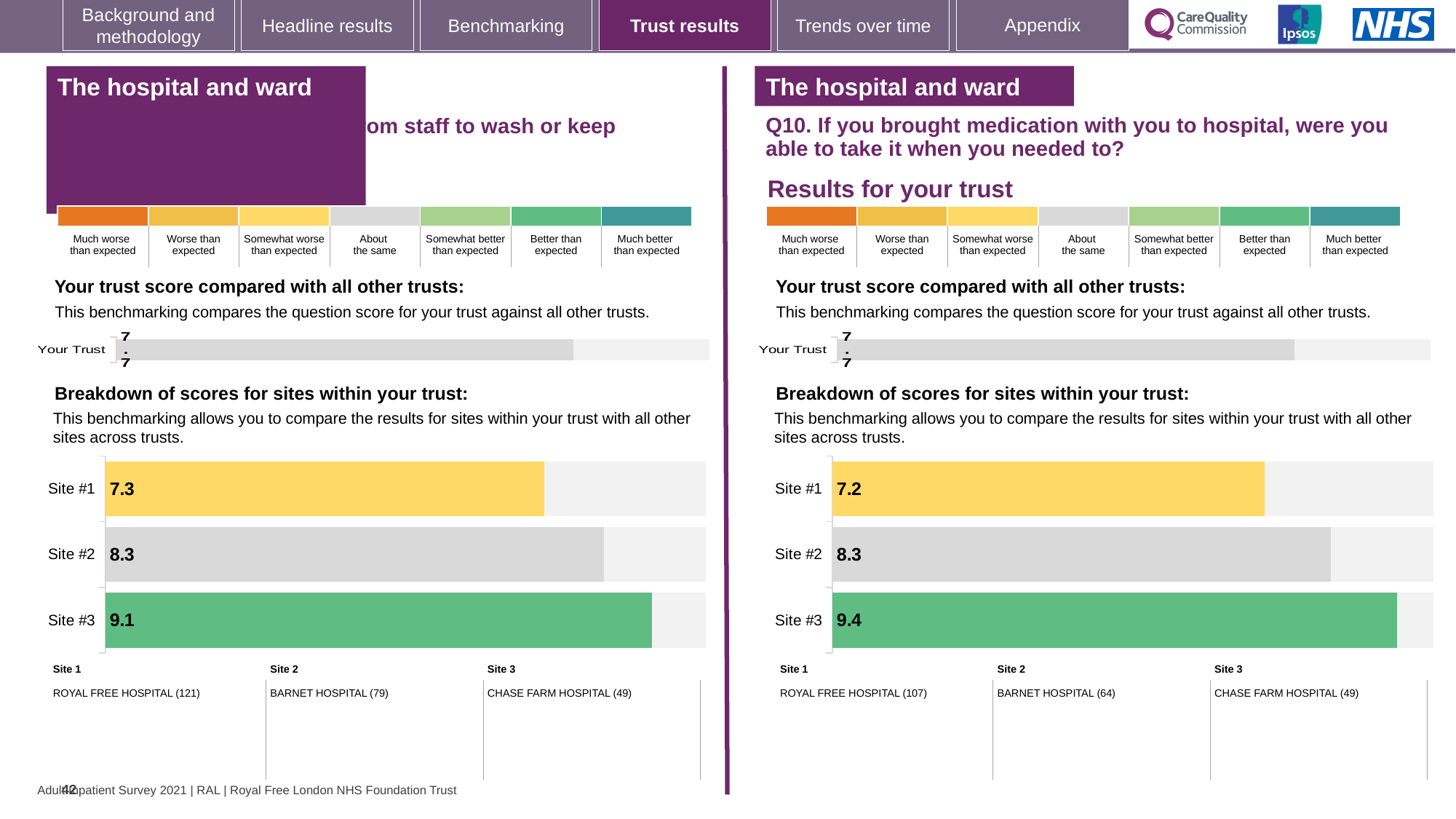
In the site breakdown chart on the left, which site has the lowest score? Site #1 In the site breakdown chart on the left, what is the difference between the scores for Site #3 and Site #2? 0.8 In the site breakdown chart on the right (Q10), which site has the highest score? Site #3 What type of chart is used for the breakdown of scores for sites on the right (Q10)? Bar chart How many sites are shown in the site breakdown chart on the right (Q10)? 3 In the site breakdown chart on the right (Q10), what is the score for Site #3? 9.4 In the site breakdown chart on the left, what is the score for Site #2? 8.3 In the site breakdown chart on the right (Q10), what is the score for Site #1? 7.2 In the site breakdown chart on the left, which has a higher score, Site #1 or Site #2? Site #2 In the site breakdown chart on the left, what is the score for Site #3? 9.1 In the site breakdown chart on the right (Q10), what is the difference between the scores for Site #3 and Site #1? 2.2 In the 'Your trust score compared with all other trusts' chart on the right (Q10), what is the score for Your Trust? 7.7